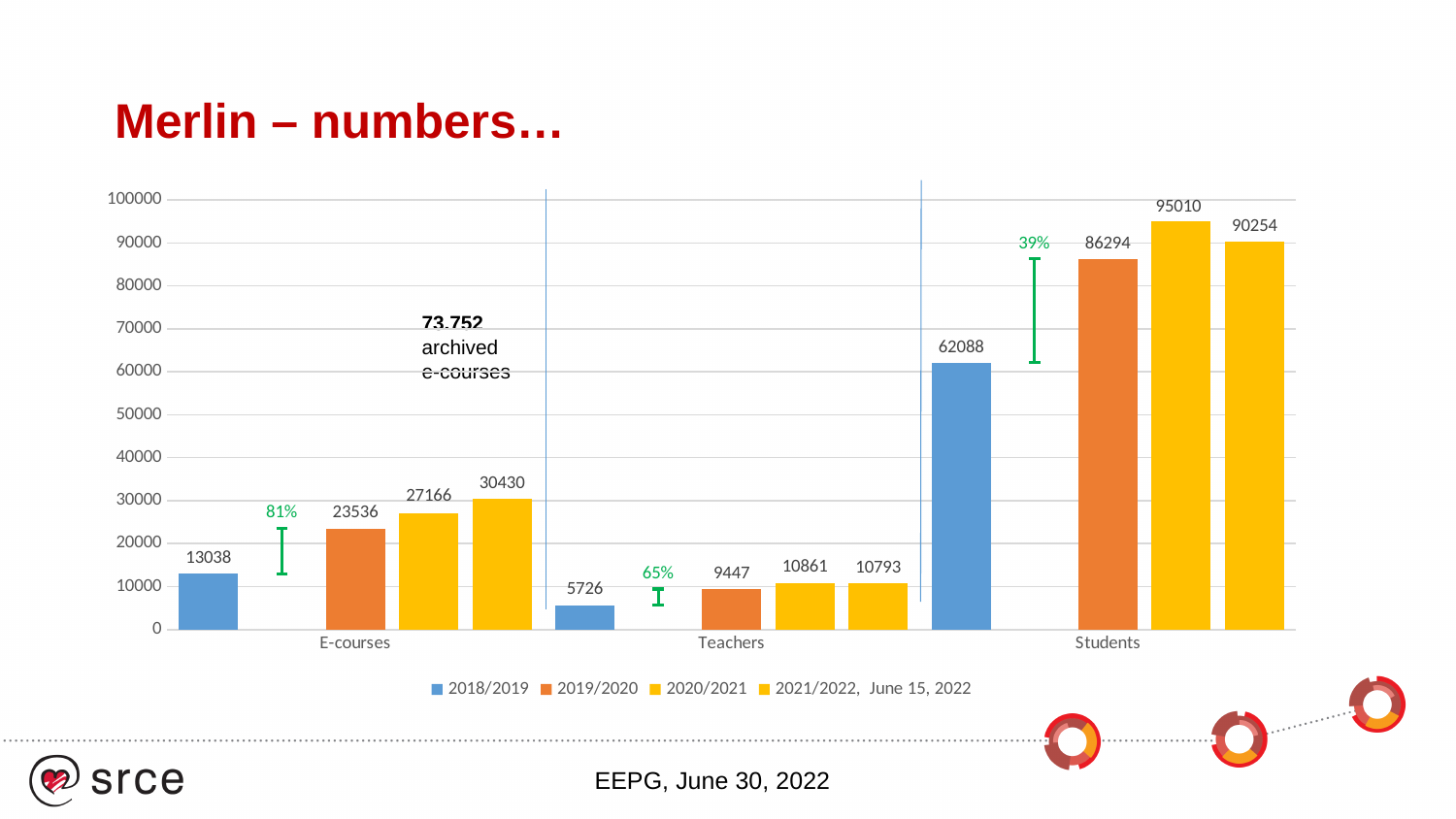
What is the value for Students in 2021/2022? 90254 Which year has the highest value for Students? 2020/2021 Which year has the lowest value for Teachers? 2018/2019 What kind of chart is shown on the slide? bar chart Which is larger, the Teachers value for 2020/2021 or for 2021/2022? 2020/2021 What is the value for Students in 2020/2021? 95010 What is the difference between the E-courses values for 2021/2022 and 2018/2019? 17392 How many series does the legend list? 4 How many categories are shown on the x axis? 3 What is the value for E-courses in 2018/2019? 13038 What is the value for Teachers in 2019/2020? 9447 What percentage increase is annotated above the Students bars? 39%